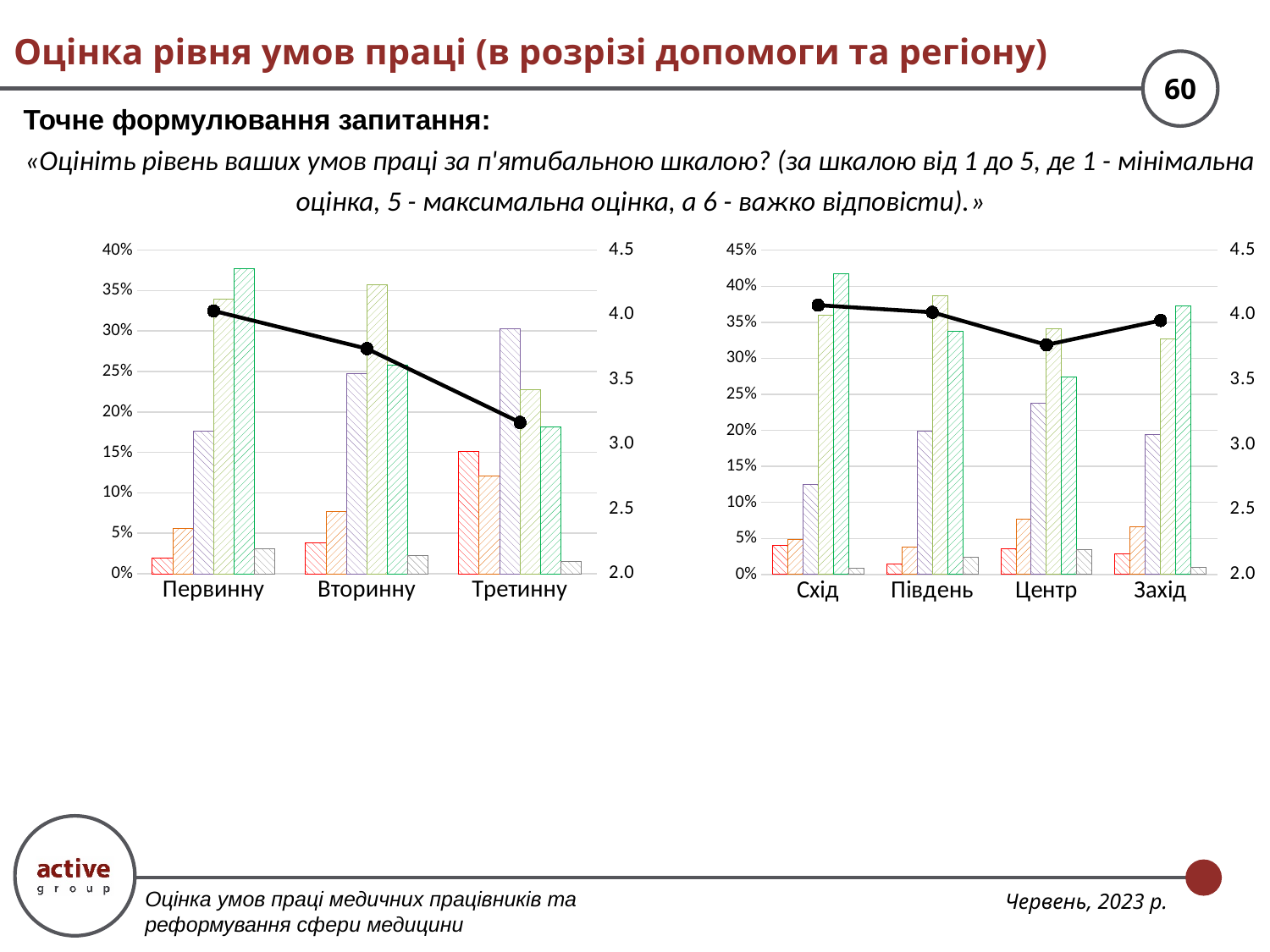
How many categories are shown on the x axis of the right chart? 4 In the left chart, for which category is the line value highest? Первинну In the right chart, is the tallest bar for Схід greater or less than 40%? greater In the left chart, is the line value for Третинну greater or less than 3.5? less In the left chart, does the line rise or fall from Первинну to Третинну? fall In the right chart, for which category is the line value lowest? Центр In the left chart, for which category is the line value lowest? Третинну What kind of chart is the left chart? bar chart with a line What is the maximum value shown on the left (percentage) axis of the right chart? 45% How many categories are shown on the x axis of the left chart? 3 In the right chart, is the line value for Центр greater or less than 4.0? less In the right chart, which has the larger line value, Схід or Центр? Схід